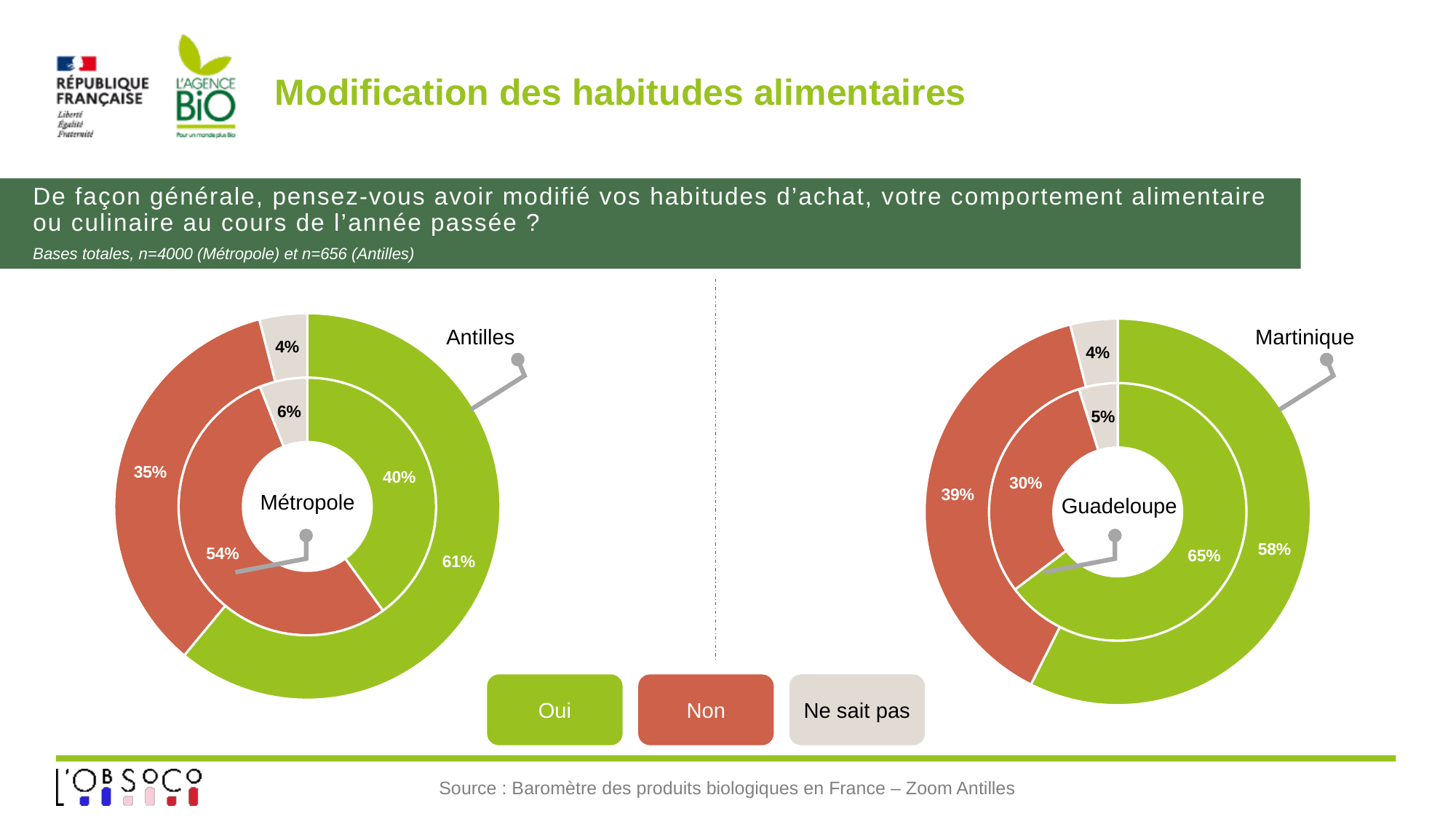
In the left chart, what share of Antilles respondents answered "Non"? 35% In the left chart, what is the difference between the "Oui" share for Antilles and the "Oui" share for Métropole? 21 percentage points In the right chart, what share of Martinique respondents answered "Ne sait pas"? 4% What kind of chart is used on this slide? Doughnut chart In the left chart, which answer has the largest share for Métropole? Non In the right chart, which has the larger "Oui" share, Guadeloupe or Martinique? Guadeloupe In the right chart, what share of Guadeloupe respondents answered "Oui"? 65% In the right chart, what is the difference between the "Non" share for Martinique and the "Non" share for Guadeloupe? 9 percentage points In the left chart, what share of Métropole respondents answered "Oui"? 40% Which colour represents the "Non" answer in the charts? Red/orange How many answer categories does the legend list? 3 In the right chart, which answer has the smallest share for Martinique? Ne sait pas